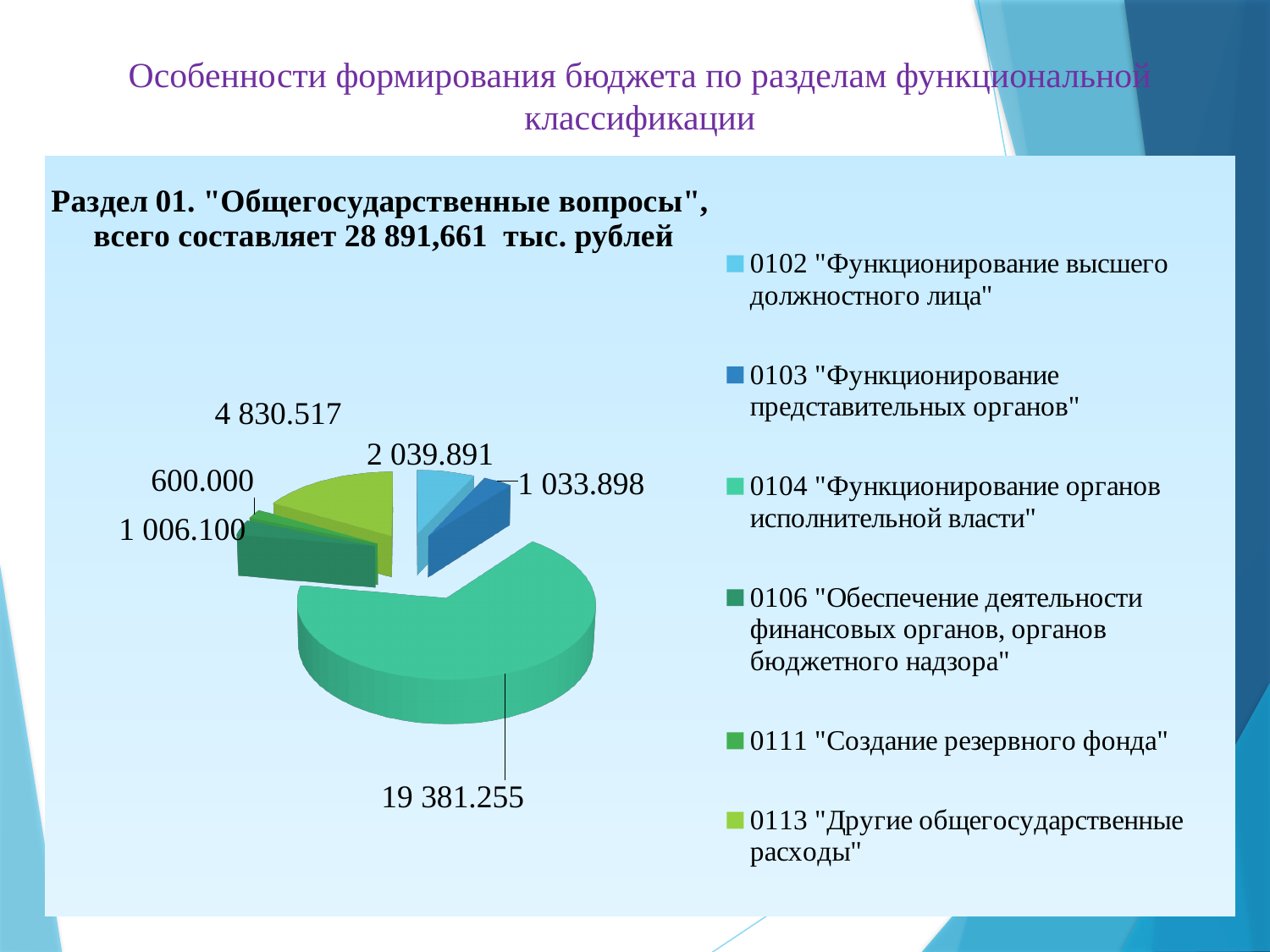
What value is shown for slice 0104 "Функционирование органов исполнительной власти"? 19 381.255 What value is shown for slice 0111 "Создание резервного фонда"? 600.000 What is the difference between the values for 0106 and 0111? 406.100 What value is shown for slice 0102 "Функционирование высшего должностного лица"? 2 039.891 How many slices does the pie chart have? 6 What value is shown for slice 0113 "Другие общегосударственные расходы"? 4 830.517 Which is larger, the value for 0103 or the value for 0106? 0103 Which category has the smallest slice of the pie? 0111 "Создание резервного фонда" What type of chart is shown on the slide? Pie chart What is the total of all slices according to the chart title? 28 891,661 тыс. рублей What is the difference between the values for 0113 and 0102? 2 790.626 Which category has the largest slice of the pie? 0104 "Функционирование органов исполнительной власти"